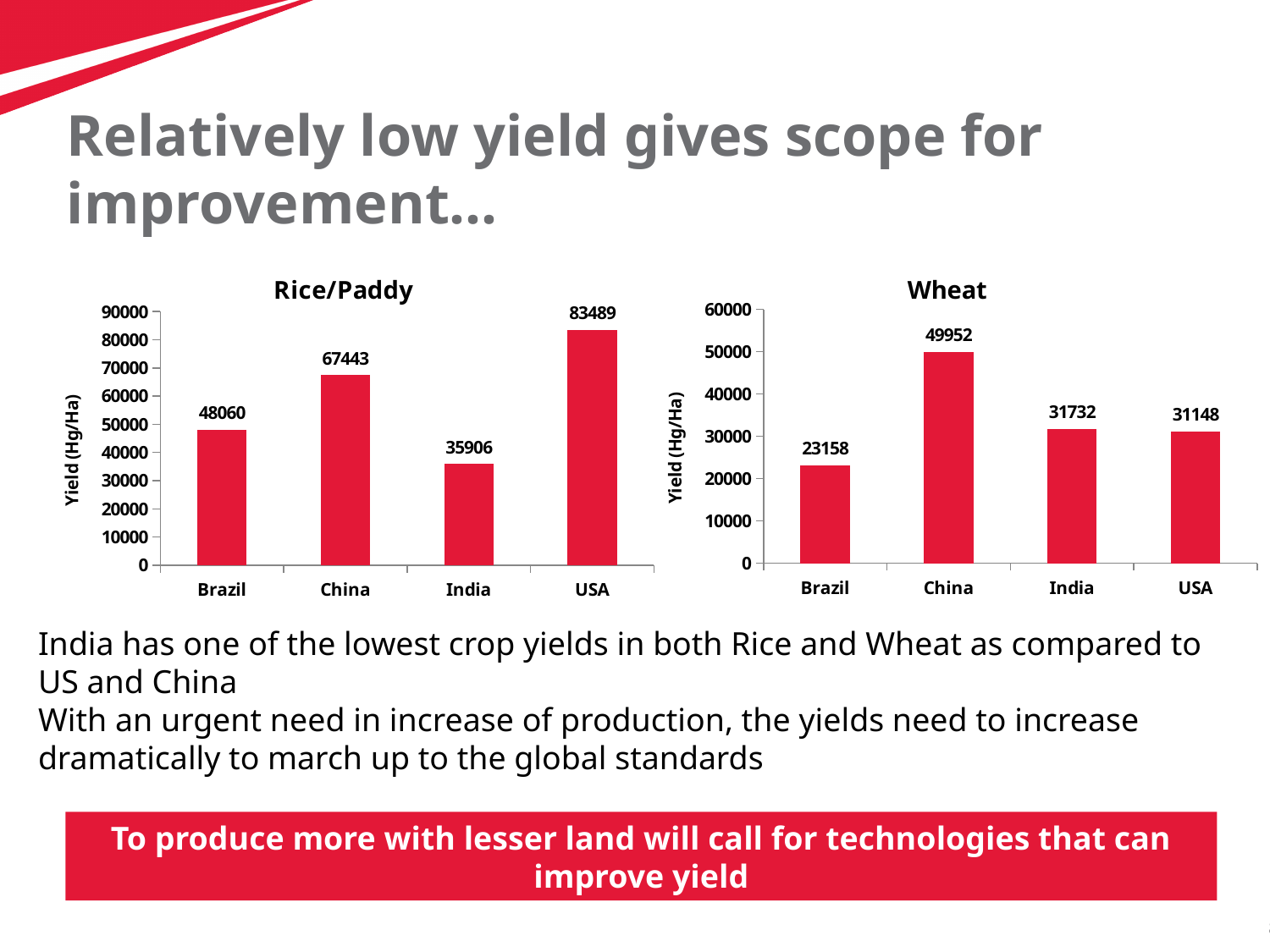
In the Wheat chart, is the value for India greater or less than 30000? greater In the Rice/Paddy chart, what is the difference between the USA yield and the India yield? 47583 In the Rice/Paddy chart, which is larger, the yield for Brazil or the yield for China? China In the Wheat chart, what is the difference between the China yield and the Brazil yield? 26794 What kind of chart is the Rice/Paddy chart? Bar chart How many countries are shown in the Wheat chart? 4 In the Wheat chart, what is the yield for China? 49952 In the Rice/Paddy chart, what is the yield for India? 35906 In the Wheat chart, what is the yield for Brazil? 23158 In the Wheat chart, which country has the lowest yield? Brazil What is the y-axis label on the Wheat chart? Yield (Hg/Ha) In the Rice/Paddy chart, which country has the highest yield? USA